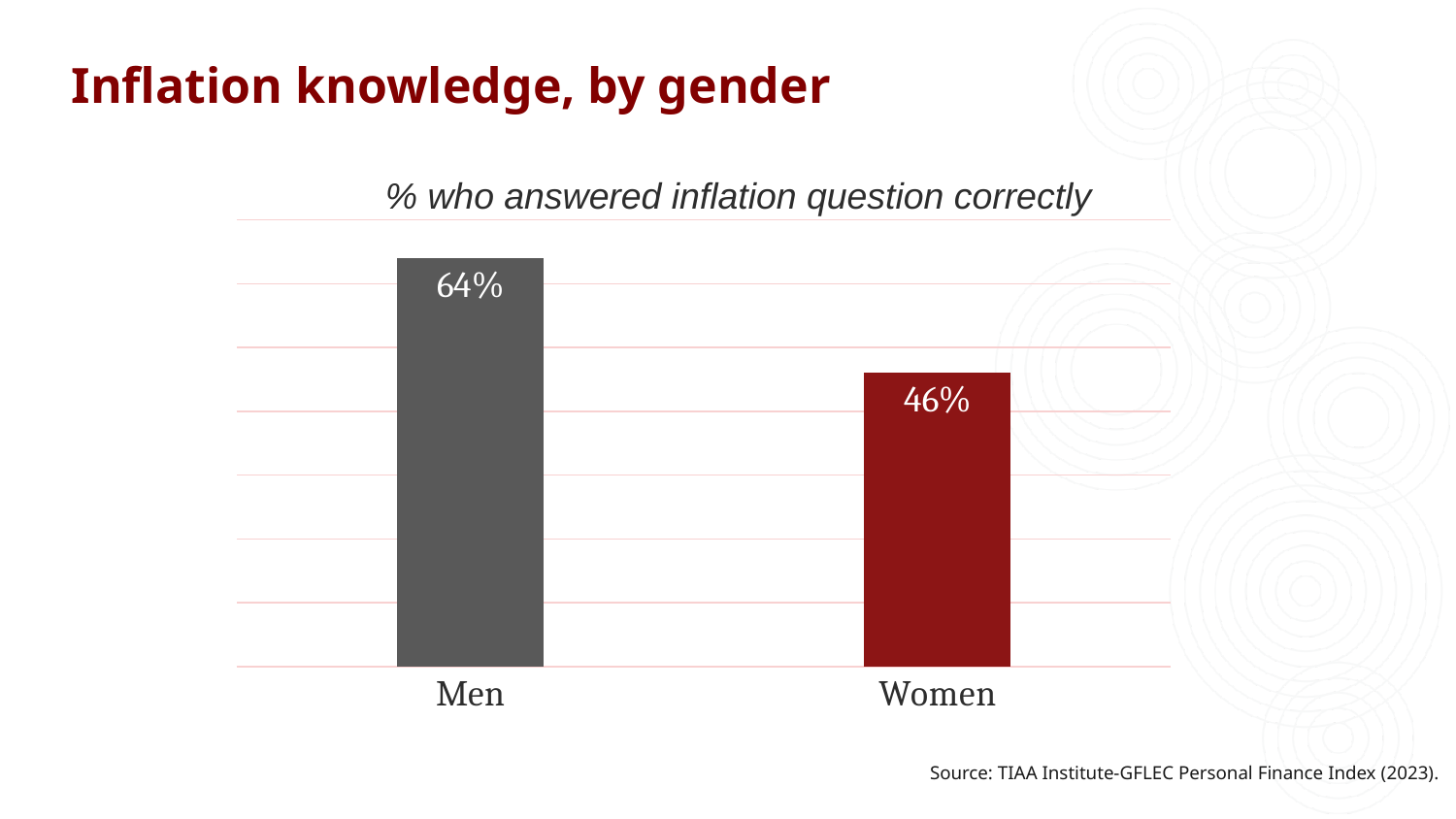
Is the value for women larger or smaller than the value for men? Smaller What percentage of women answered the inflation question correctly? 46% What colour is the bar for Women? Dark red What is the title of the chart? % who answered inflation question correctly What is the difference in percentage points between men and women answering the inflation question correctly? 18 percentage points Which group has the higher share answering the inflation question correctly? Men Which group has the lower share answering the inflation question correctly? Women What kind of chart is shown on the slide? Bar chart What is the source cited for the chart? TIAA Institute-GFLEC Personal Finance Index (2023) What percentage of men answered the inflation question correctly? 64% How many categories are shown in the chart? 2